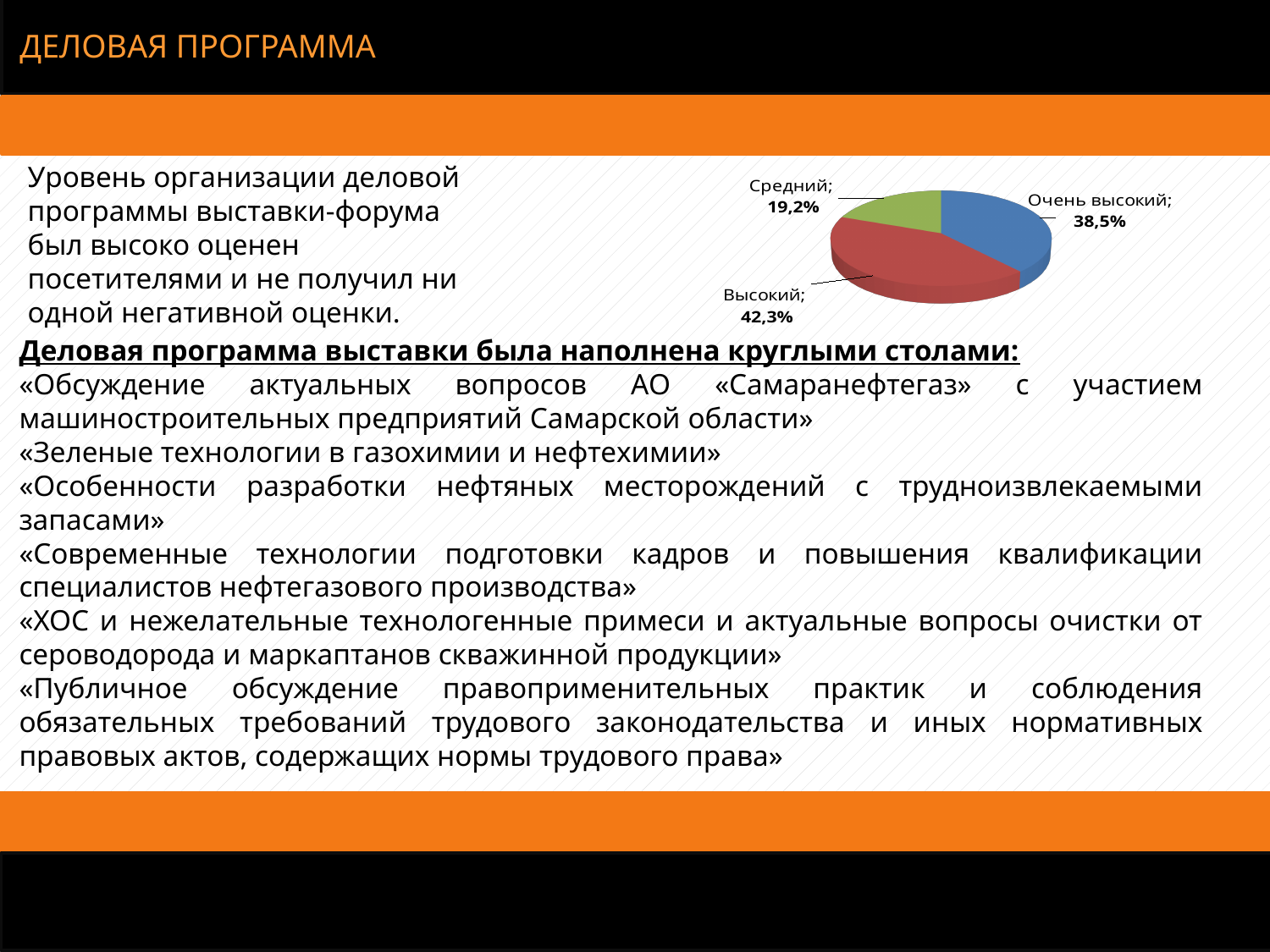
Which slice is larger, "Очень высокий" or "Средний"? Очень высокий What is the difference in percentage points between the "Высокий" and "Очень высокий" slices? 3,8 What share of the pie does the "Очень высокий" slice represent? 38,5% Which category has the largest slice in the pie chart? Высокий What colour is the "Средний" slice in the pie chart? green What is the difference in percentage points between the "Очень высокий" and "Средний" slices? 19,3 What colour is the "Высокий" slice in the pie chart? red What share of the pie does the "Средний" slice represent? 19,2% What kind of chart is shown on the slide? pie chart What share of the pie does the "Высокий" slice represent? 42,3% How many slices does the pie chart have? 3 Which category has the smallest slice in the pie chart? Средний